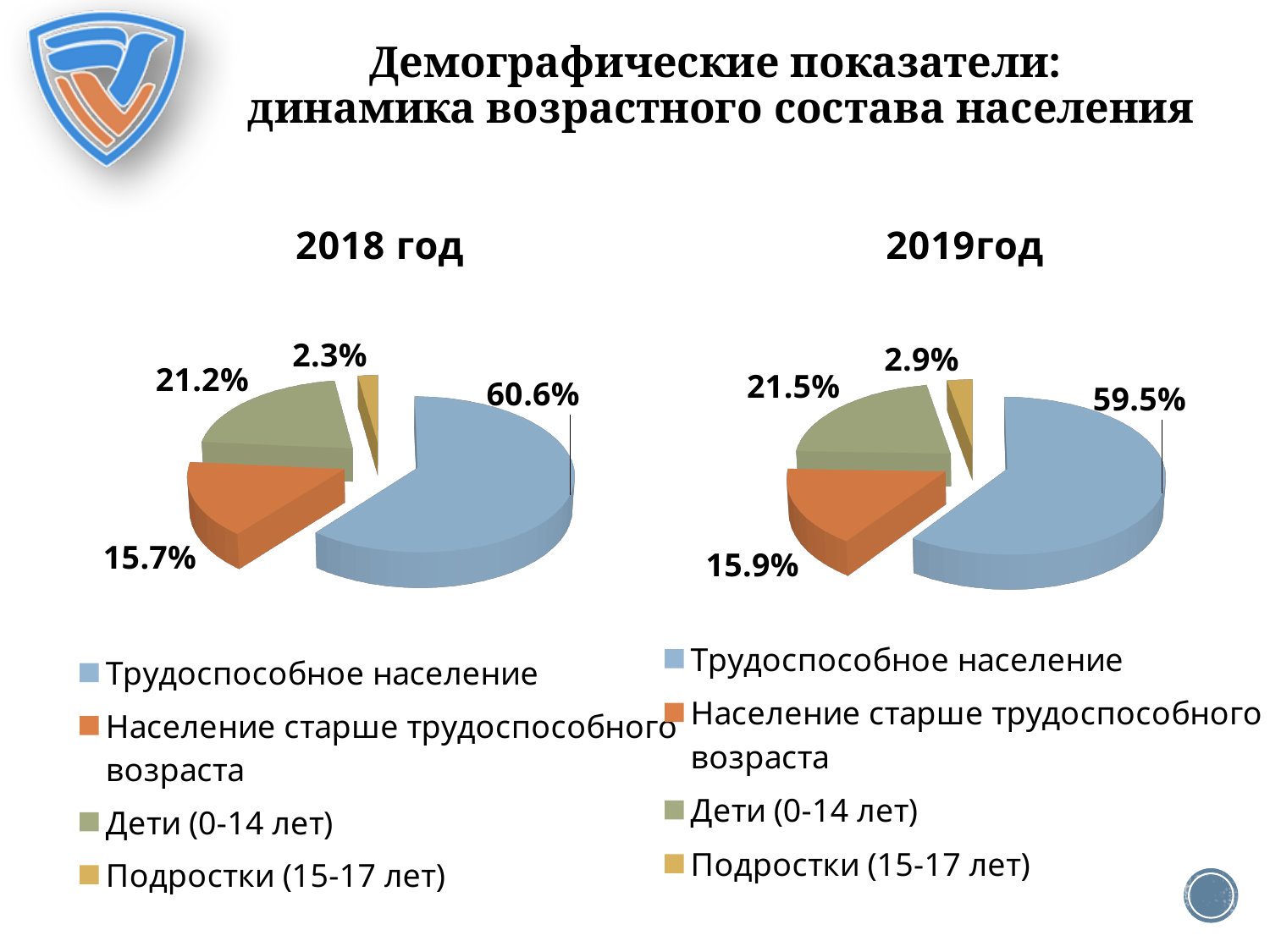
In the "2018 год" chart, what share is shown for Подростки (15-17 лет)? 2.3% In the "2018 год" chart, which colour represents Дети (0-14 лет)? Green What type of chart is used for "2019год"? Pie chart In the "2019год" chart, what share is shown for Дети (0-14 лет)? 21.5% In the "2019год" chart, which category has the smallest slice? Подростки (15-17 лет) How many slices does the "2018 год" chart have? 4 In the "2018 год" chart, which category has the largest slice? Трудоспособное население What is the difference between the share of Трудоспособное население in the "2018 год" chart and in the "2019год" chart? 1.1% In the "2018 год" chart, what share is shown for Трудоспособное население? 60.6% Which is larger: the share of Подростки (15-17 лет) in the "2018 год" chart or in the "2019год" chart? 2019год In the "2019год" chart, what is the difference between the shares of Дети (0-14 лет) and Население старше трудоспособного возраста? 5.6% In the "2019год" chart, what share is shown for Население старше трудоспособного возраста? 15.9%